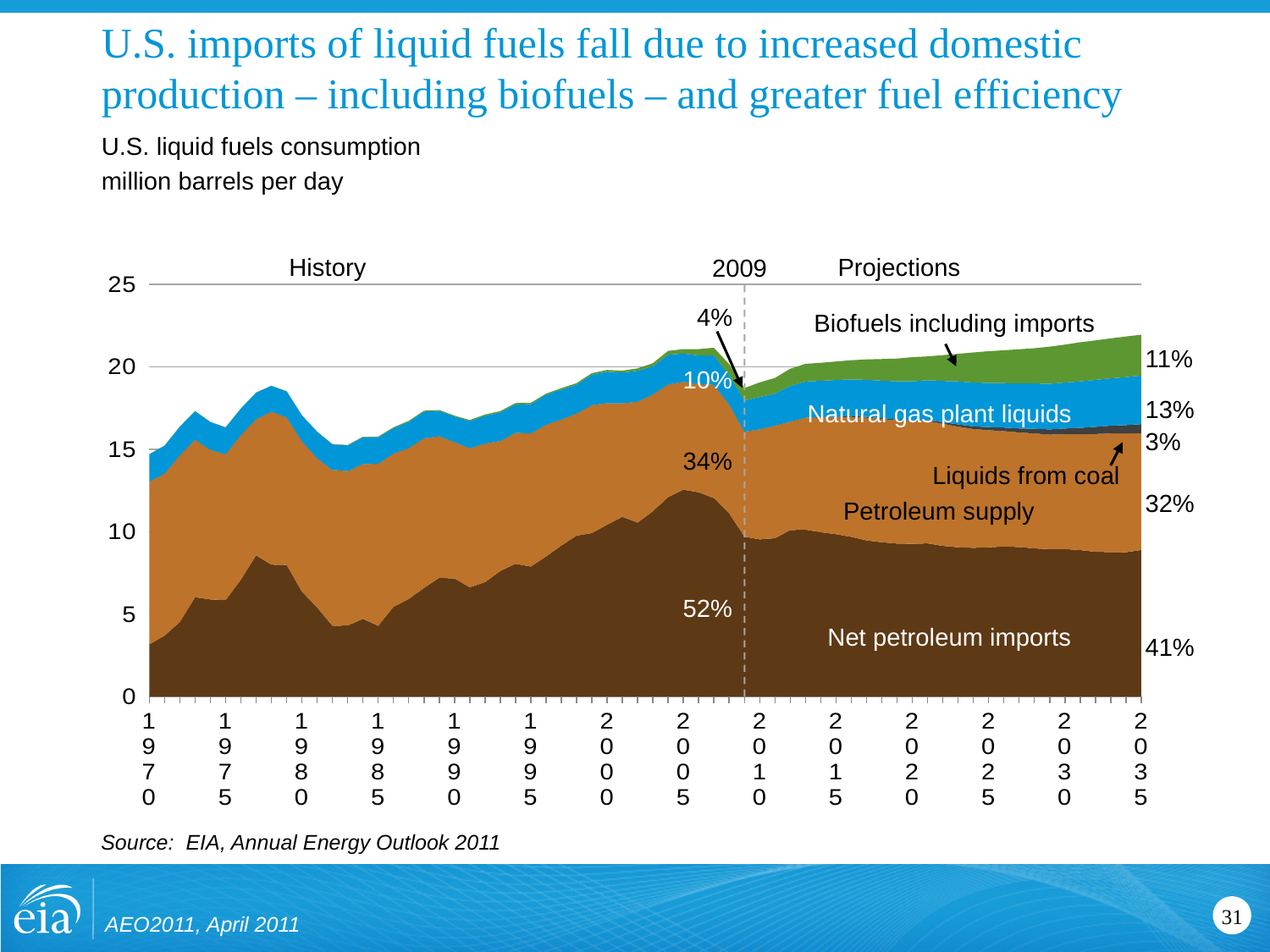
Is total U.S. liquid fuels consumption in 2035 greater or less than 20 million barrels per day? greater How many components of liquid fuels consumption are labeled in the chart? 5 In 2035, which has the larger share: natural gas plant liquids or biofuels including imports? Natural gas plant liquids What share of U.S. liquid fuels consumption is projected for biofuels including imports in 2035? 11% What share of U.S. liquid fuels consumption did net petroleum imports account for in 2009? 52% What kind of chart is shown on the slide? Stacked area chart What share of U.S. liquid fuels consumption did natural gas plant liquids account for in 2009? 10% By how many percentage points does the share of net petroleum imports change from 2009 (52%) to 2035 (41%)? 11 percentage points Which component has the largest share of U.S. liquid fuels consumption in 2035? Net petroleum imports What share of U.S. liquid fuels consumption is projected for petroleum supply in 2035? 32% What share of U.S. liquid fuels consumption is projected for liquids from coal in 2035? 3% Which component has the smallest share of U.S. liquid fuels consumption in 2009? Biofuels including imports